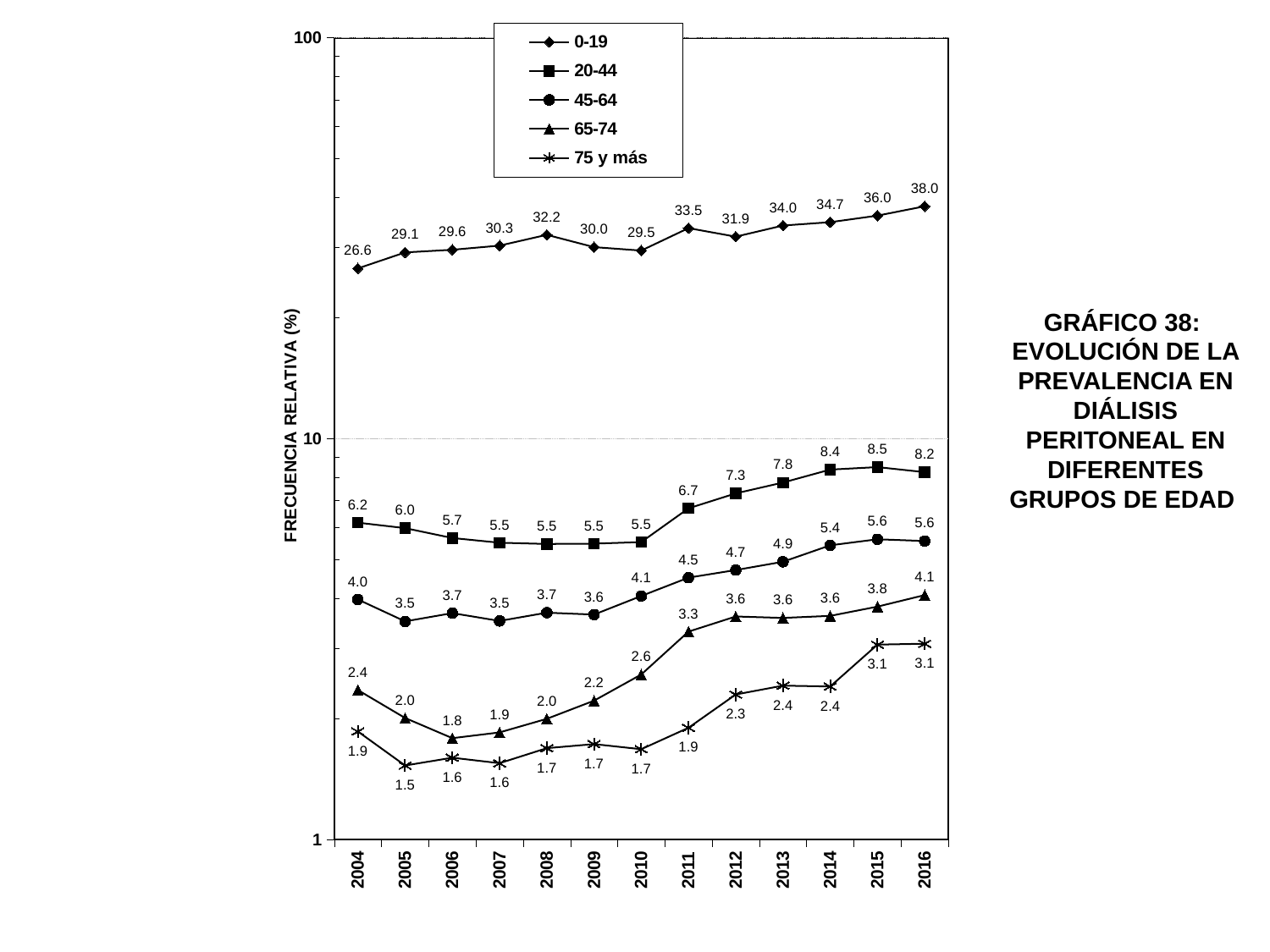
How many years are shown on the x axis? 13 What is the difference between the 0-19 values in 2016 and 2004? 11.4 What is the value for the 0-19 series in 2016? 38.0 What is the label of the y axis? FRECUENCIA RELATIVA (%) How many series does the legend list? 5 What type of chart is shown on the slide? Line chart Does the 20-44 series generally rise or fall from 2010 to 2015? Rise What is the value for the 20-44 series in 2015? 8.5 What is the value for the 75 y más series in 2005? 1.5 In which year is the 0-19 series highest? 2016 Which is larger in 2010: the 45-64 value or the 65-74 value? 45-64 In which year is the 65-74 series lowest? 2006